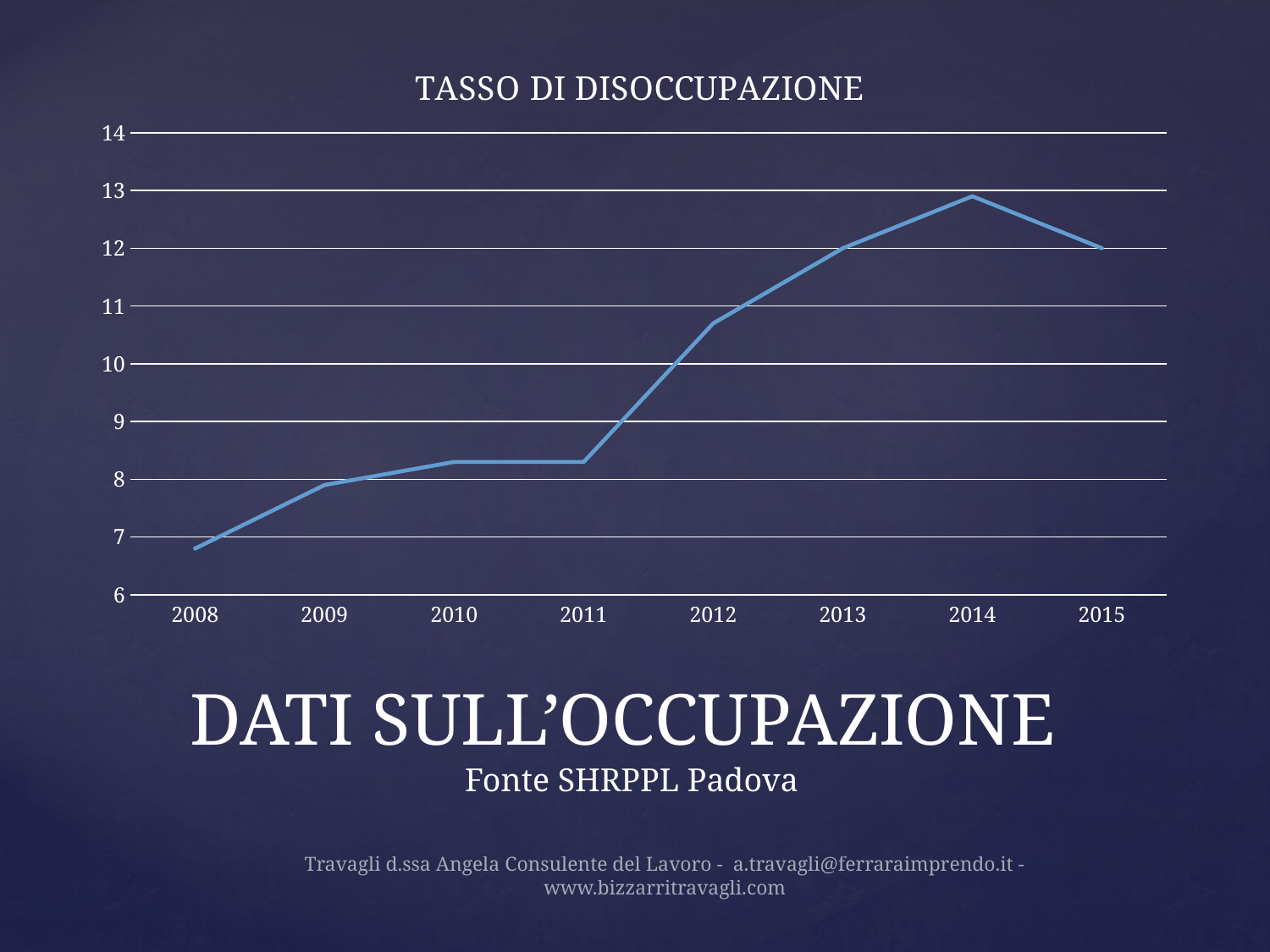
Which year has the lowest unemployment rate in the chart? 2008 Which is larger, the value for 2012 or the value for 2011? 2012 Is the value for 2008 greater or less than 7? less Do the values rise or fall from 2014 to 2015? fall What kind of chart is shown on the slide? line chart Is the value for 2012 greater or less than 10? greater What is the title of the chart? TASSO DI DISOCCUPAZIONE How many years are plotted on the x axis of the chart? 8 Which year has the highest unemployment rate in the chart? 2014 Do the values rise or fall from 2008 to 2014? rise Is the value for 2010 greater or less than 8? greater